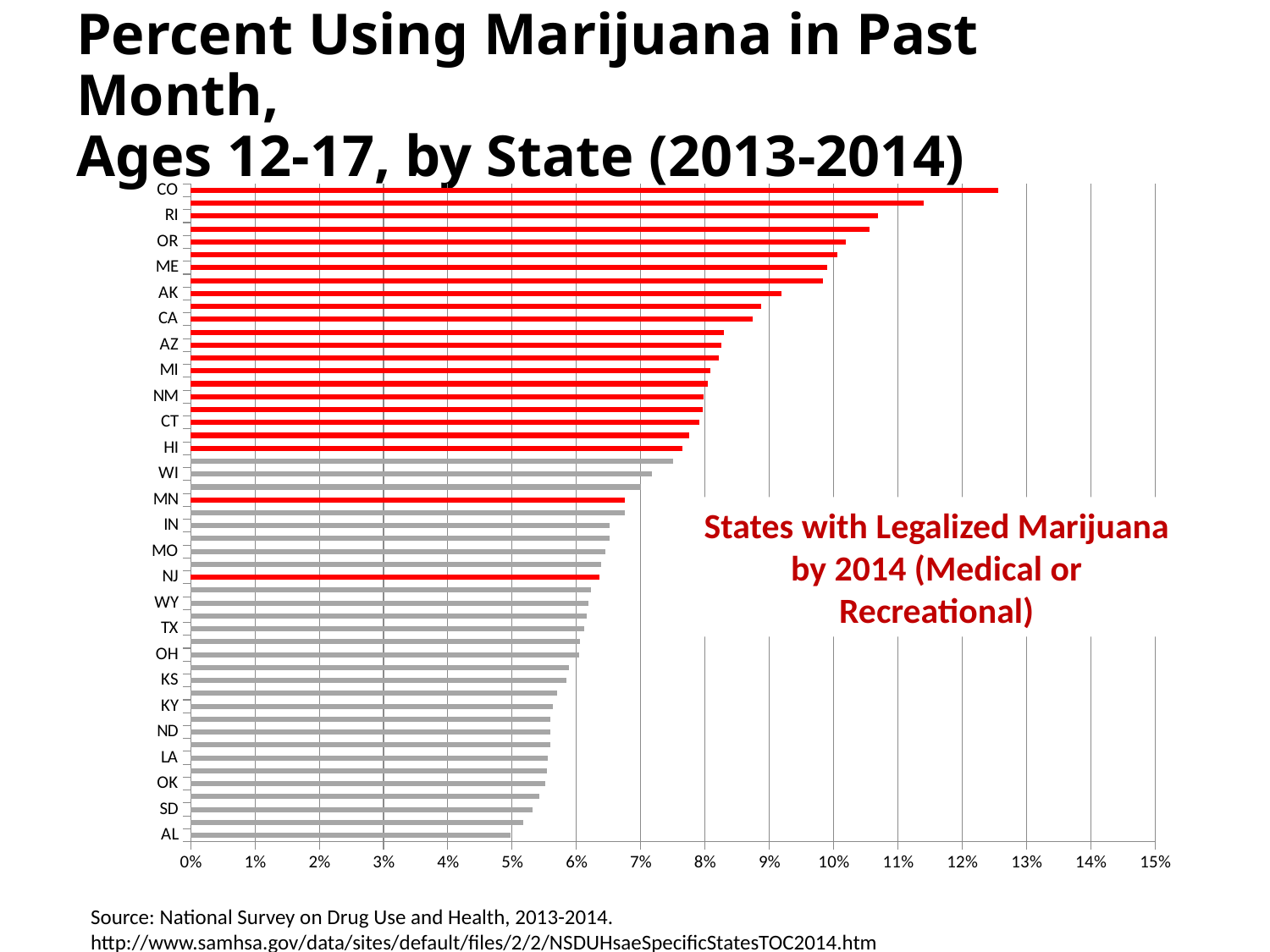
What kind of chart is shown on the slide? bar chart Is the value for RI greater or less than 10%? greater According to the annotation, what do the red bars represent? States with Legalized Marijuana by 2014 (Medical or Recreational) Is the value for KS greater or less than 6%? less Which labeled state has the lowest percent using marijuana in the past month? AL Is the value for HI greater or less than 8%? less Which has a higher value, CO or RI? CO Which state has the highest percent using marijuana in the past month? CO Which has a higher value, WI or AL? WI